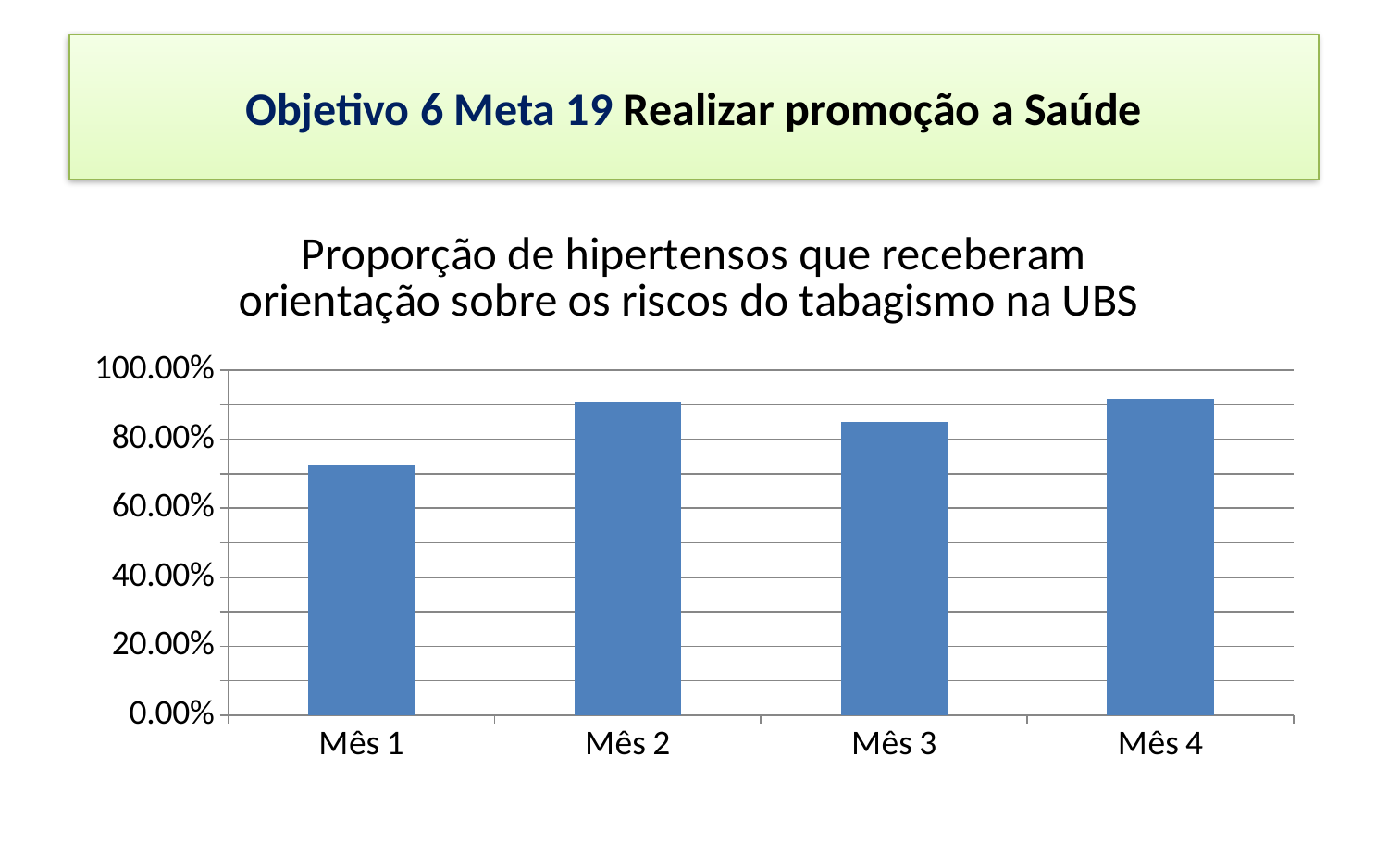
What kind of chart is shown on the slide? bar chart What is the highest value shown on the vertical axis of the chart? 100.00% Is the value for Mês 3 greater or less than 80.00%? greater What is the title of the chart? Proporção de hipertensos que receberam orientação sobre os riscos do tabagismo na UBS Which month has the lowest proportion of hypertensive patients who received guidance on the risks of smoking? Mês 1 Is the value for Mês 1 greater or less than 60.00%? greater Is the value for Mês 1 greater or less than 80.00%? less Which is larger, the value for Mês 2 or the value for Mês 3? Mês 2 How many months (categories) are plotted on the chart? 4 Which is larger, the value for Mês 1 or the value for Mês 3? Mês 3